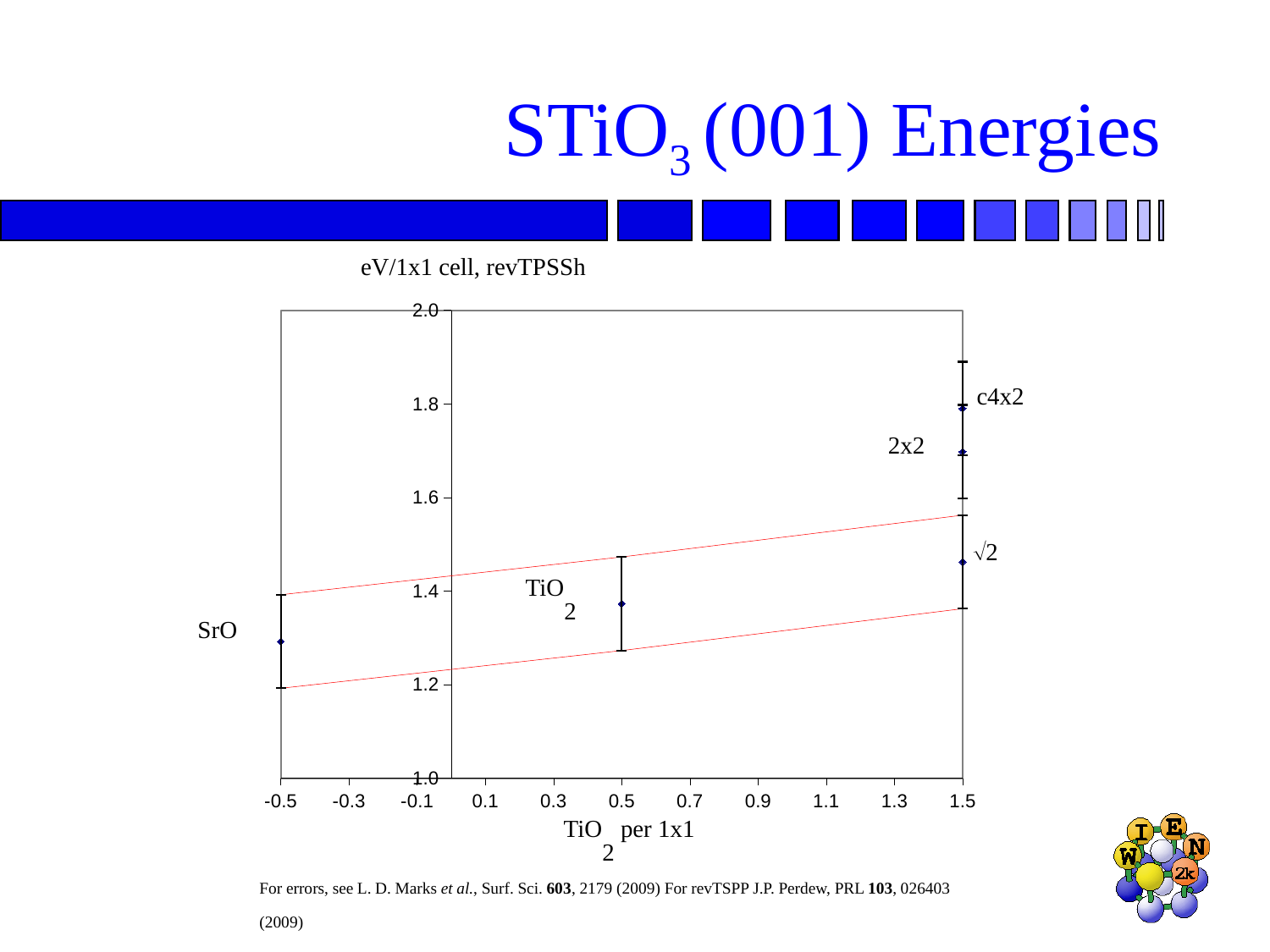
Which labeled point has the lowest energy on the chart? SrO Which has the higher energy, √2 or 2x2? 2x2 What kind of chart is shown on the slide? scatter chart Do the energies generally rise or fall as TiO2 per 1x1 increases along the x axis? rise Is the energy value for SrO greater or less than 1.4? less Which has the higher energy, c4x2 or 2x2? c4x2 How many labeled data points are plotted on the chart? 5 Is the energy value for c4x2 greater or less than 1.6? greater Which labeled point has the highest energy on the chart? c4x2 What is the label on the vertical axis of the chart? eV/1x1 cell, revTPSSh Is the energy value for √2 greater or less than 1.6? less At what x-axis value (TiO2 per 1x1) are the c4x2, 2x2 and √2 points plotted? 1.5